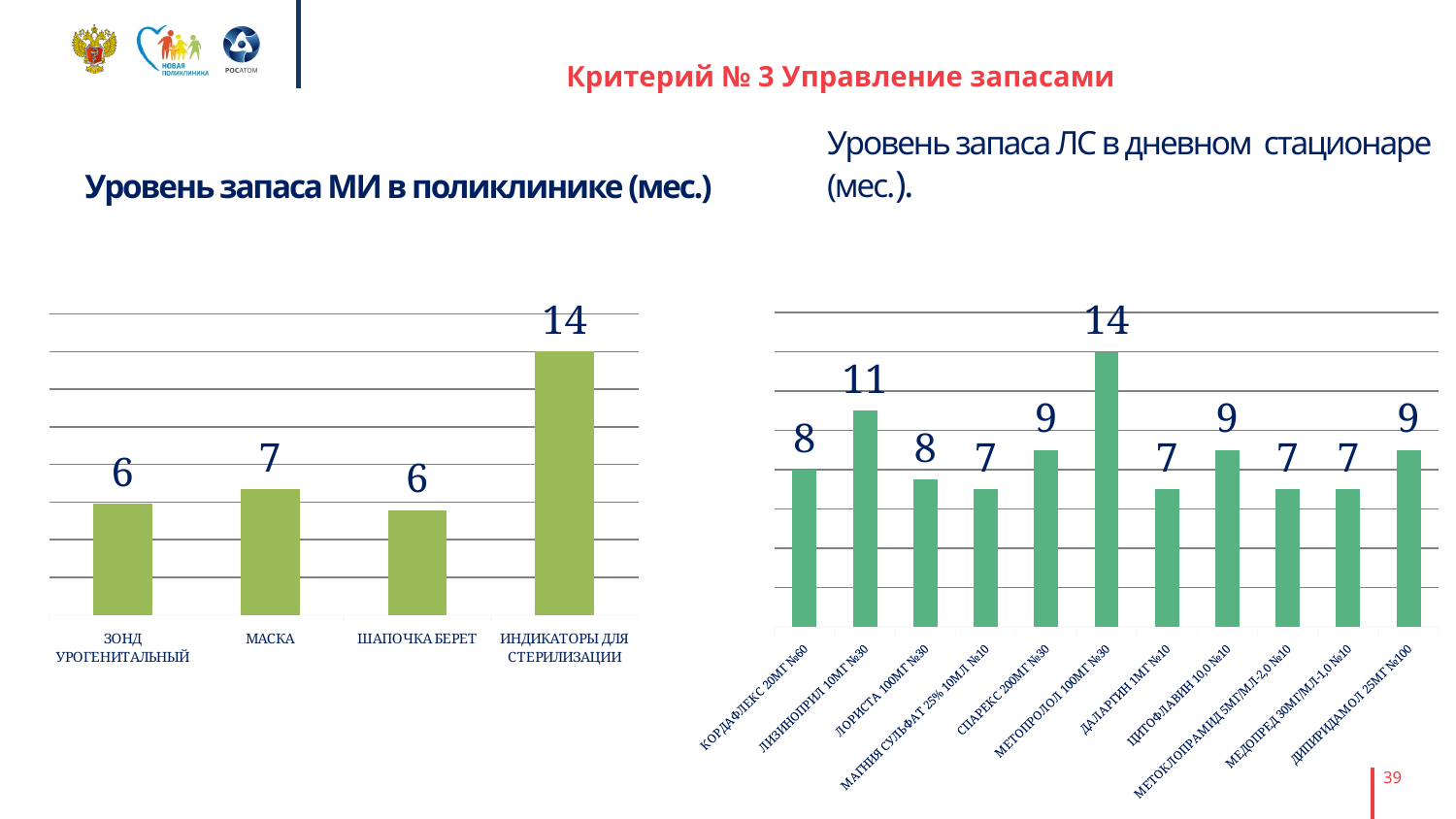
In the chart 'Уровень запаса ЛС в дневном стационаре (мес.)', what is the difference between МЕТОПРОЛОЛ 100МГ №30 and ЛИЗИНОПРИЛ 10МГ №30? 3 In the chart 'Уровень запаса МИ в поликлинике (мес.)', what is the value for МАСКА? 7 In the chart 'Уровень запаса ЛС в дневном стационаре (мес.)', which is larger: КОРДАФЛЕКС 20МГ №60 or ДАЛАРГИН 1МГ №10? КОРДАФЛЕКС 20МГ №60 In the chart 'Уровень запаса МИ в поликлинике (мес.)', what is the difference between ИНДИКАТОРЫ ДЛЯ СТЕРИЛИЗАЦИИ and ЗОНД УРОГЕНИТАЛЬНЫЙ? 8 What type of chart is 'Уровень запаса МИ в поликлинике (мес.)'? bar chart In the chart 'Уровень запаса ЛС в дневном стационаре (мес.)', what is the value for ЛИЗИНОПРИЛ 10МГ №30? 11 In the chart 'Уровень запаса МИ в поликлинике (мес.)', which category has the highest value? ИНДИКАТОРЫ ДЛЯ СТЕРИЛИЗАЦИИ In the chart 'Уровень запаса ЛС в дневном стационаре (мес.)', which category has the highest value? МЕТОПРОЛОЛ 100МГ №30 How many categories are shown in the chart 'Уровень запаса ЛС в дневном стационаре (мес.)'? 11 In the chart 'Уровень запаса ЛС в дневном стационаре (мес.)', what is the value for СПАРЕКС 200МГ №30? 9 What colour are the bars in the chart 'Уровень запаса ЛС в дневном стационаре (мес.)'? green How many categories are shown in the chart 'Уровень запаса МИ в поликлинике (мес.)'? 4